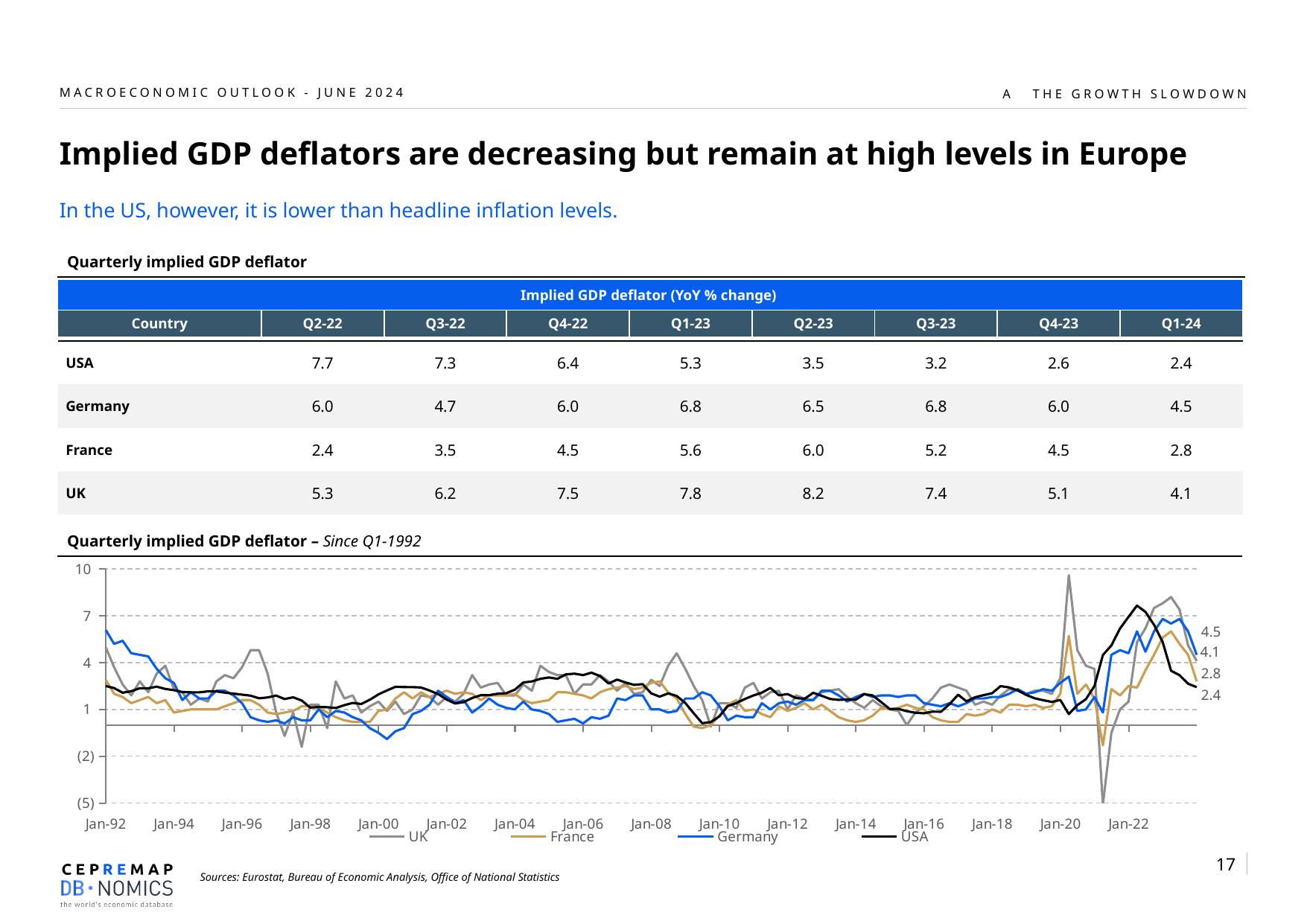
In the 'Quarterly implied GDP deflator – Since Q1-1992' chart, which has the larger end label, the UK or France? UK In the 'Quarterly implied GDP deflator – Since Q1-1992' chart, what is the value labelled at the end of the Germany line? 4.5 What kind of chart is the 'Quarterly implied GDP deflator – Since Q1-1992' chart? line chart In the 'Quarterly implied GDP deflator – Since Q1-1992' chart, what is the value labelled at the end of the France line? 2.8 How many series does the legend of the 'Quarterly implied GDP deflator – Since Q1-1992' chart list? 4 In the 'Quarterly implied GDP deflator – Since Q1-1992' chart, which colour is used for the USA line? black In the 'Quarterly implied GDP deflator – Since Q1-1992' chart, which series has the lowest labelled value at the end of the chart? USA In the 'Quarterly implied GDP deflator – Since Q1-1992' chart, what is the value labelled at the end of the USA line? 2.4 In the 'Quarterly implied GDP deflator – Since Q1-1992' chart, what is the difference between the end labels for Germany and the USA? 2.1 In the 'Quarterly implied GDP deflator – Since Q1-1992' chart, is the lowest point of the UK line shortly after Jan-20 greater or less than (2)? less In the 'Quarterly implied GDP deflator – Since Q1-1992' chart, is the UK peak around Jan-20 greater or less than 7? greater In the 'Quarterly implied GDP deflator – Since Q1-1992' chart, which series has the highest labelled value at the end of the chart? Germany